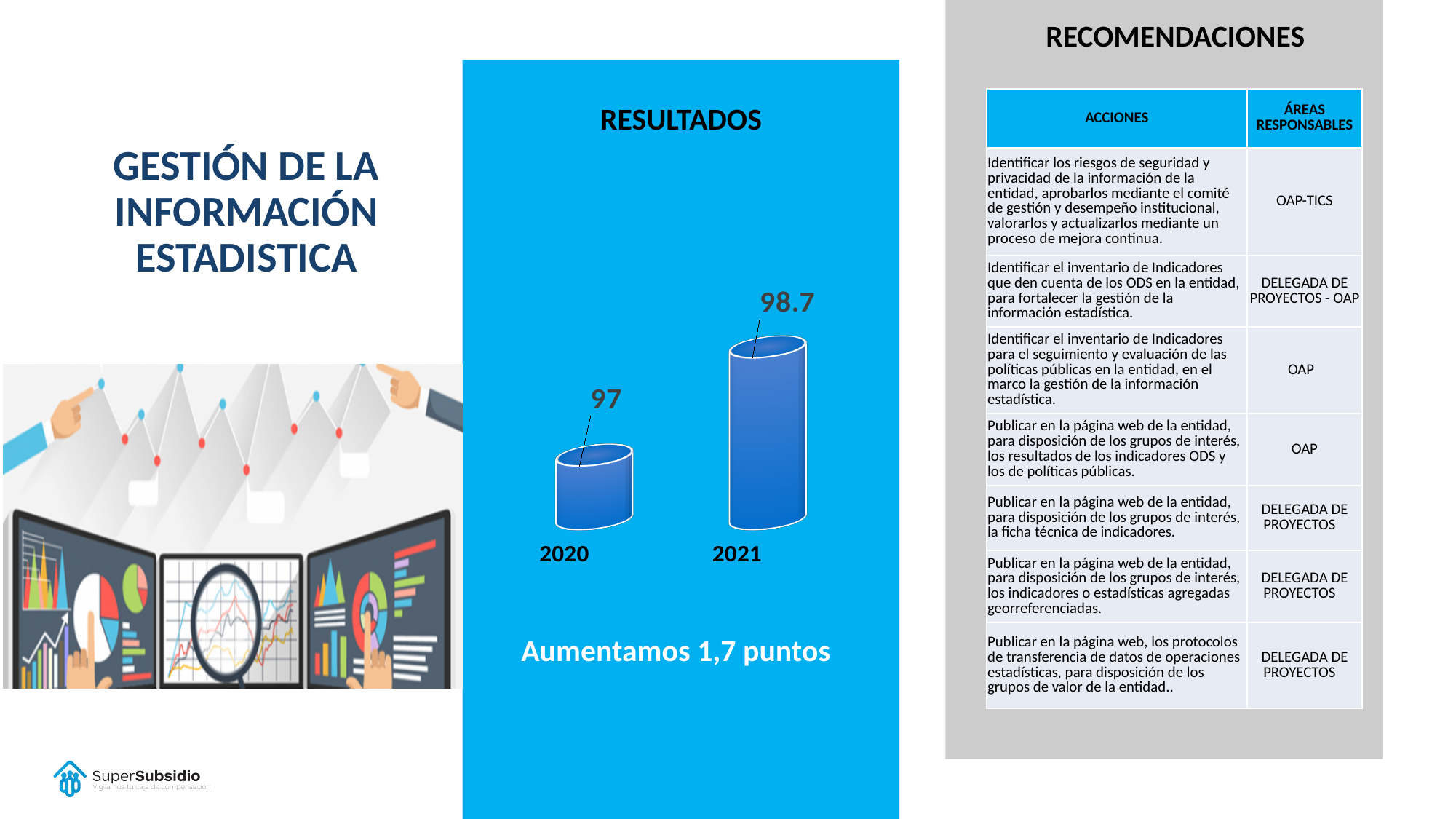
What text appears below the RESULTADOS chart summarising the change? Aumentamos 1,7 puntos What is the difference between the 2021 and 2020 values in the RESULTADOS chart? 1.7 Which year has the highest value in the RESULTADOS chart? 2021 How many categories are shown in the RESULTADOS chart? 2 What is the value for 2020 in the RESULTADOS chart? 97 What kind of chart is the RESULTADOS chart? bar chart In the RESULTADOS chart, is the value for 2021 larger or smaller than the value for 2020? larger Do the values in the RESULTADOS chart rise or fall from 2020 to 2021? rise What is the title of the chart on the slide? RESULTADOS Which year has the lowest value in the RESULTADOS chart? 2020 What is the value for 2021 in the RESULTADOS chart? 98.7